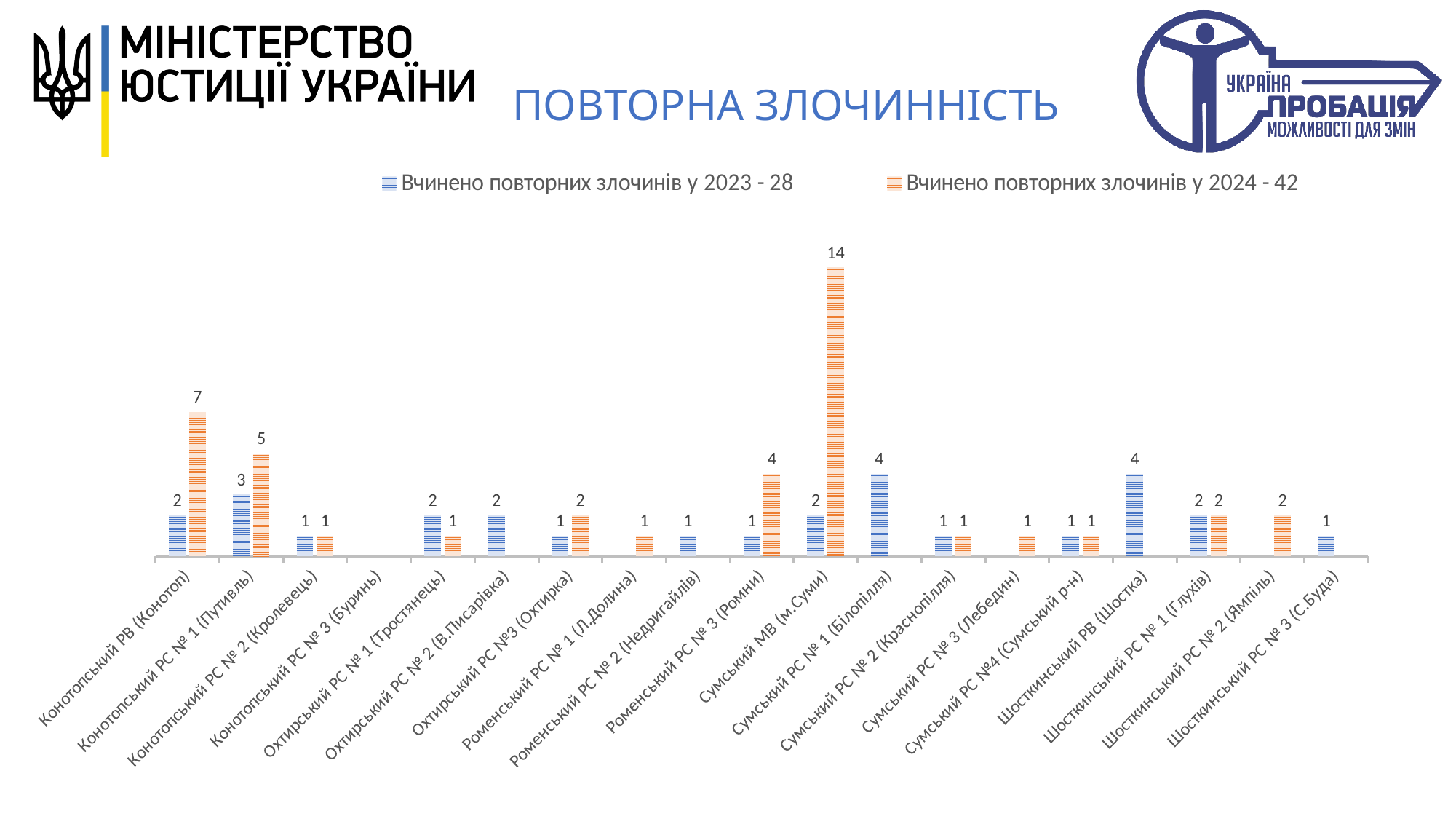
What type of chart is shown on the slide? bar chart What is the value for Конотопський РВ (Конотоп) in the 2023 series? 2 What is the value for Конотопський РС № 1 (Путивль) in the 2024 series? 5 How many series does the legend list? 2 What is the difference between the 2024 and 2023 values for Сумський МВ (м.Суми)? 12 What is the value for Сумський МВ (м.Суми) in the 2024 series? 14 How many categories are shown along the x axis? 19 What is the difference between the 2024 and 2023 values for Конотопський РВ (Конотоп)? 5 Which category has the highest value in the 2024 series? Сумський МВ (м.Суми) Which is larger for Охтирський РС № 1 (Тростянець): the 2023 value or the 2024 value? 2023 What total does the legend give for repeat crimes committed in 2024? 42 Which is larger for Роменський РС № 3 (Ромни): the 2023 value or the 2024 value? 2024